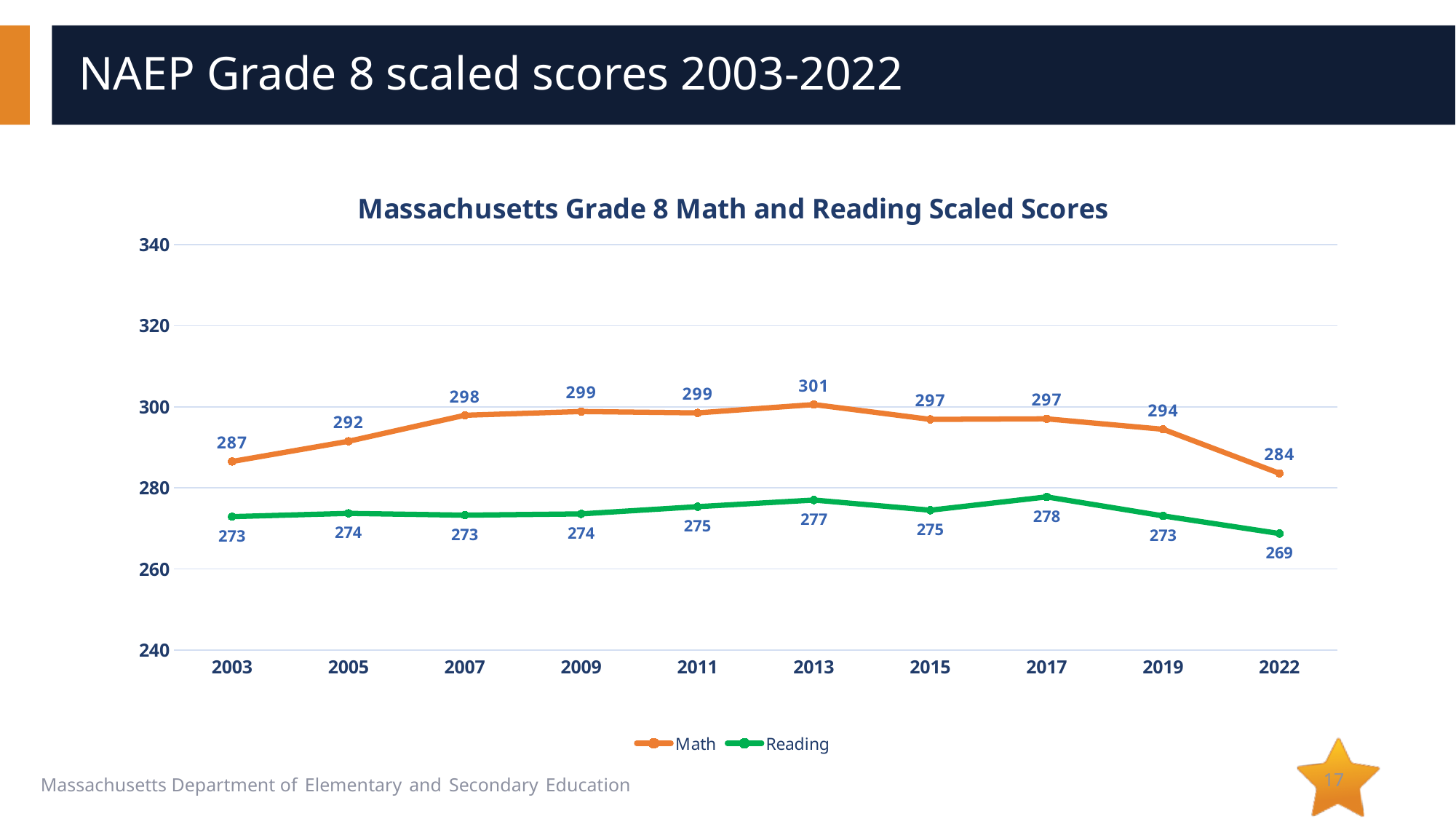
What is the difference between the Math and Reading scaled scores in 2022? 15 How many years are shown on the x axis? 10 How many series does the legend list? 2 What was the Math scaled score in 2003? 287 In which year was the Reading scaled score lowest? 2022 What was the Reading scaled score in 2022? 269 In which year was the Math scaled score highest? 2013 Which was higher in 2017, the Math score or the Reading score? Math How much did the Math scaled score drop from 2019 to 2022? 10 Did the Math scaled score rise or fall from 2013 to 2022? Fall What was the Math scaled score in 2013? 301 What kind of chart is shown on the slide? Line chart